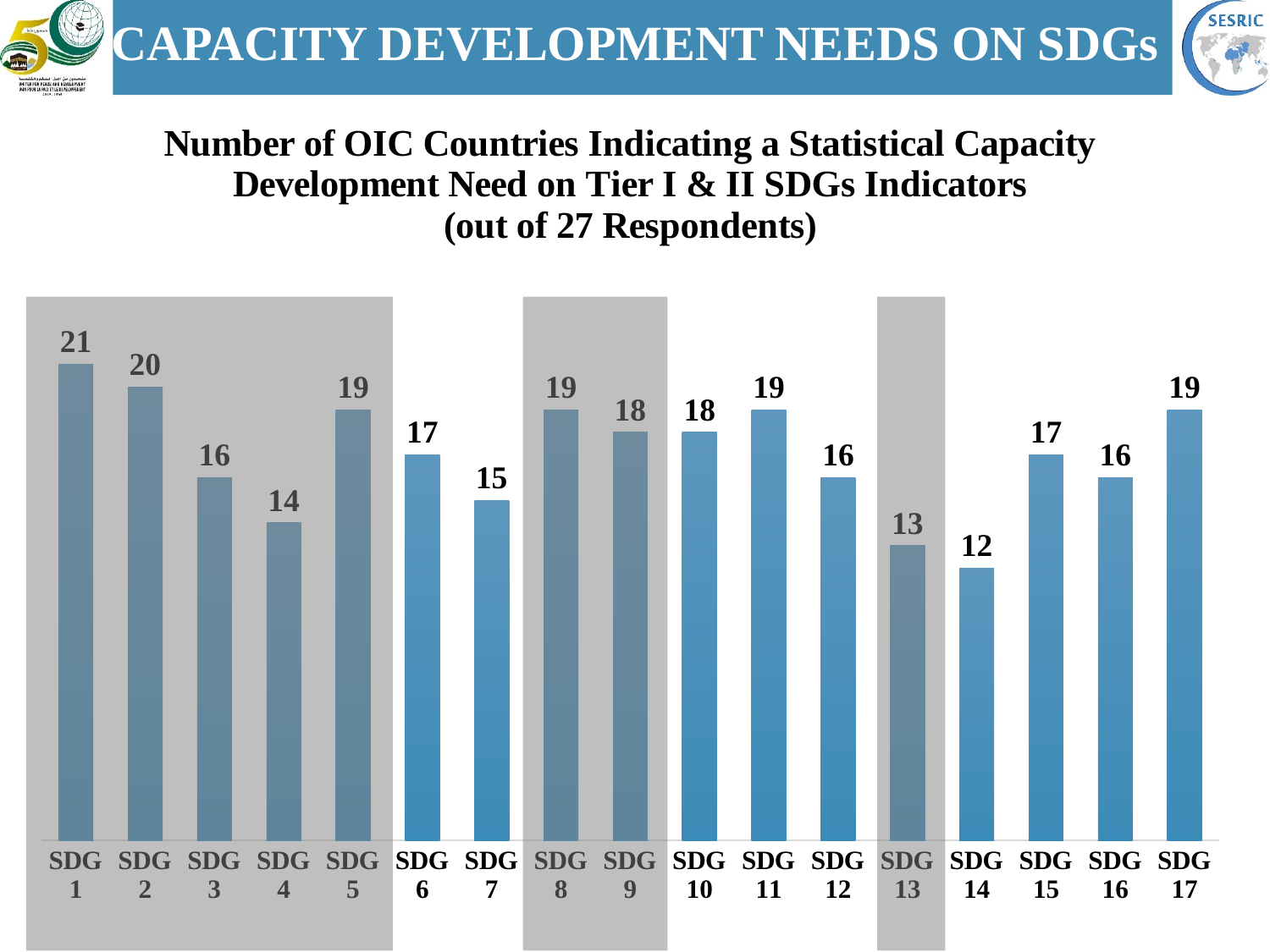
What is the value for SDG 1? 21 Which SDG has the highest number of countries indicating a capacity development need? SDG 1 What is the difference between the values for SDG 1 and SDG 14? 9 Which SDG has the lowest number of countries indicating a capacity development need? SDG 14 Which is larger, the value for SDG 7 or the value for SDG 10? SDG 10 How many respondents does the chart title say the numbers are out of? 27 What is the value for SDG 14? 12 How many SDG categories are shown on the chart? 17 What kind of chart is shown on the slide? Bar chart What is the value for SDG 13? 13 What is the difference between the values for SDG 2 and SDG 4? 6 Which SDGs share the value 19? SDG 5, SDG 8, SDG 11, SDG 17